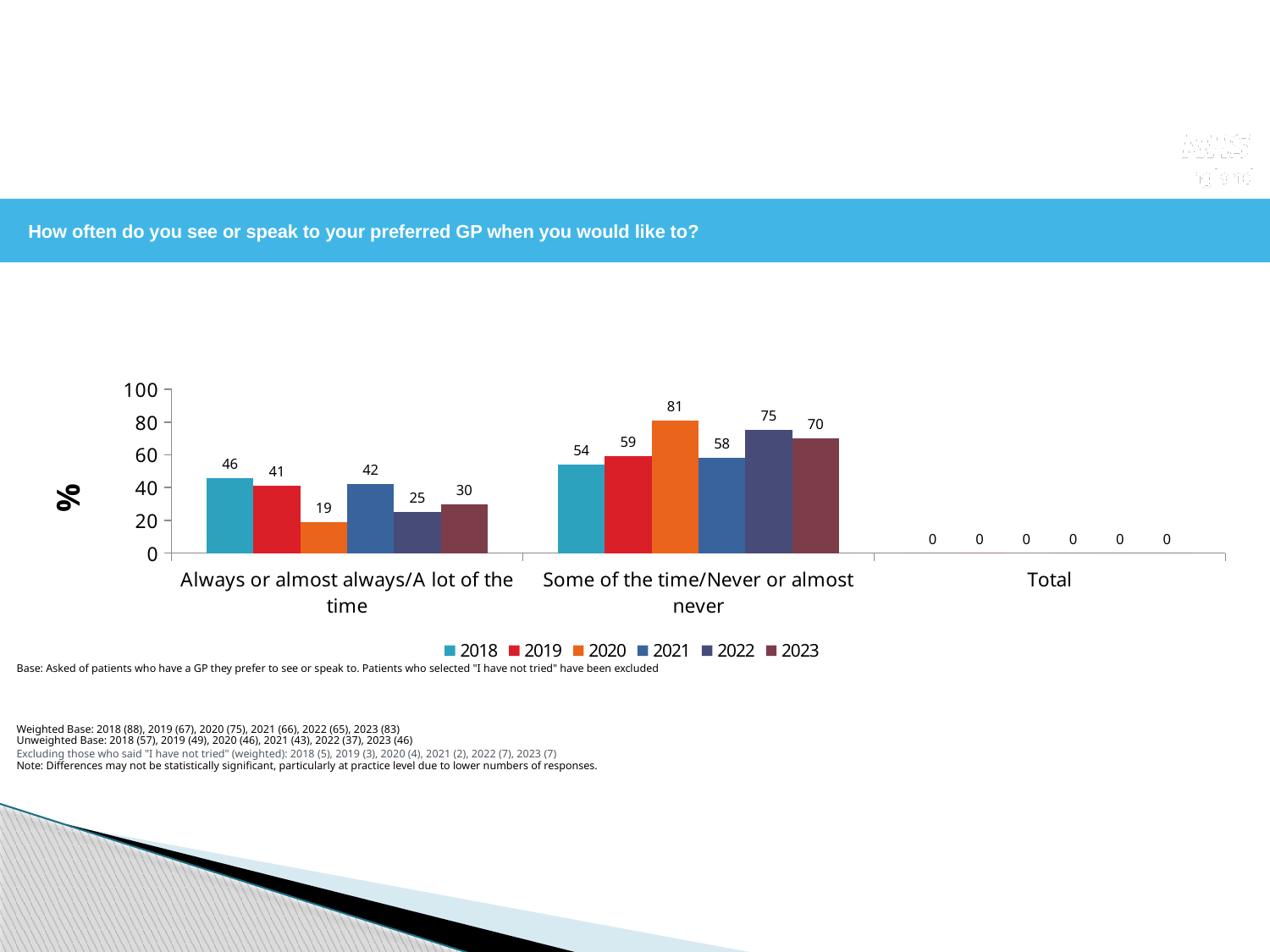
Which year has the highest value in the 'Some of the time/Never or almost never' category? 2020 What is the title of the chart? How often do you see or speak to your preferred GP when you would like to? How many series does the legend list? 6 How many categories are shown on the x axis? 3 What is the value for 2023 in the 'Always or almost always/A lot of the time' category? 30 Which year has the lowest value in the 'Always or almost always/A lot of the time' category? 2020 What is the value for 2020 in the 'Always or almost always/A lot of the time' category? 19 What is the difference between the 2018 and 2023 values in the 'Always or almost always/A lot of the time' category? 16 Is the value for 2021 in the 'Some of the time/Never or almost never' category greater or less than 60? less Which is larger in the 'Some of the time/Never or almost never' category: the value for 2019 or the value for 2021? 2019 What kind of chart is shown on the slide? Bar chart What is the value for 2022 in the 'Some of the time/Never or almost never' category? 75